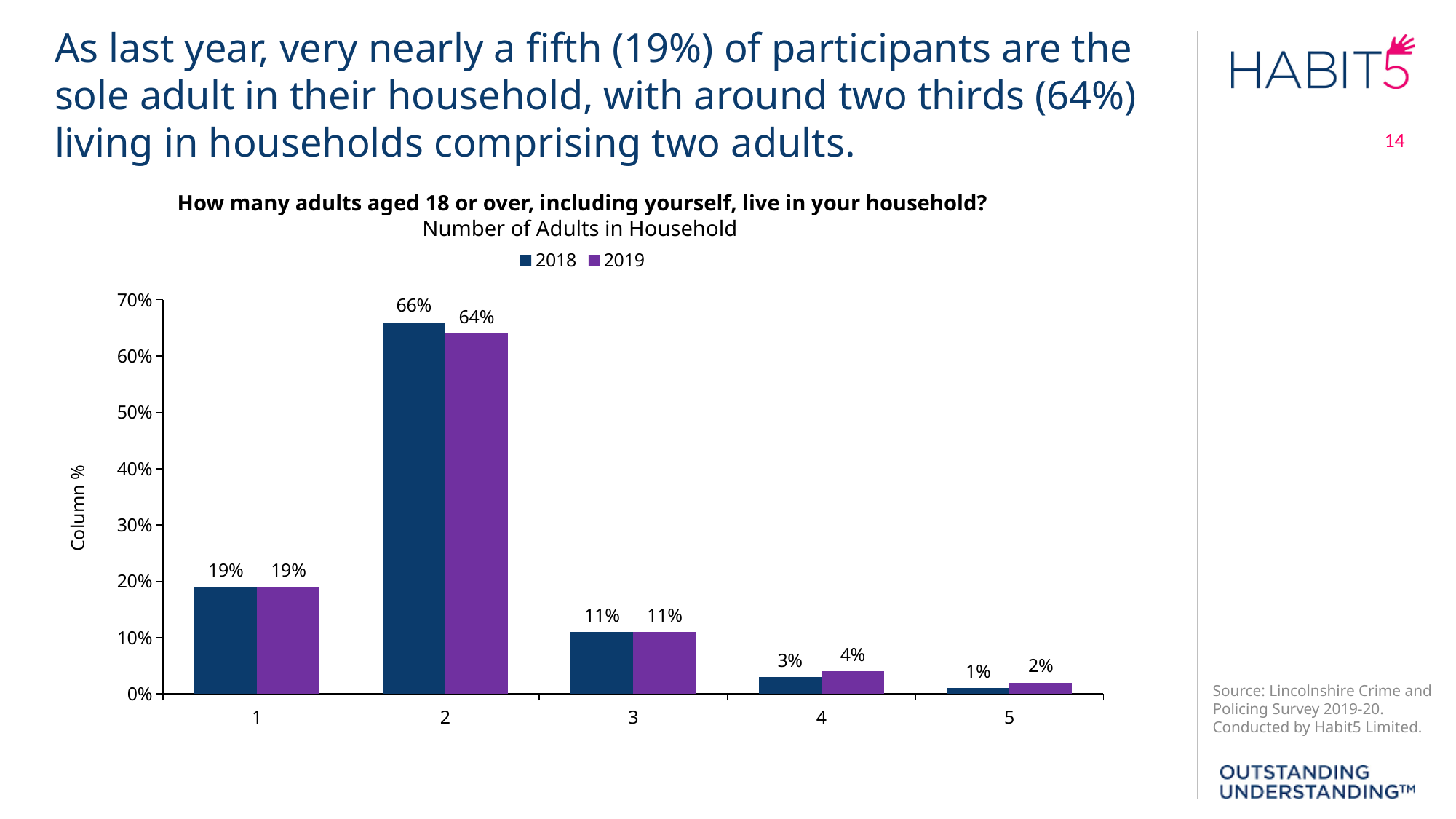
What percentage of participants in 2018 had 1 adult in their household? 19% What percentage of participants in 2019 had 2 adults in their household? 64% Which number of adults in household has the highest percentage in 2018? 2 Is the 2018 value for households with 2 adults greater or less than 60%? greater How many series does the legend list? 2 What kind of chart is shown on the slide? Bar chart Which is larger: the 2019 value for 1 adult or the 2019 value for 3 adults? 1 adult What is the 2019 value for households with 4 adults? 4% What is the label of the y axis? Column % What is the difference between the 2018 and 2019 values for households with 2 adults? 2% Which number of adults in household has the lowest percentage in 2019? 5 How many categories of number of adults are shown on the x axis? 5